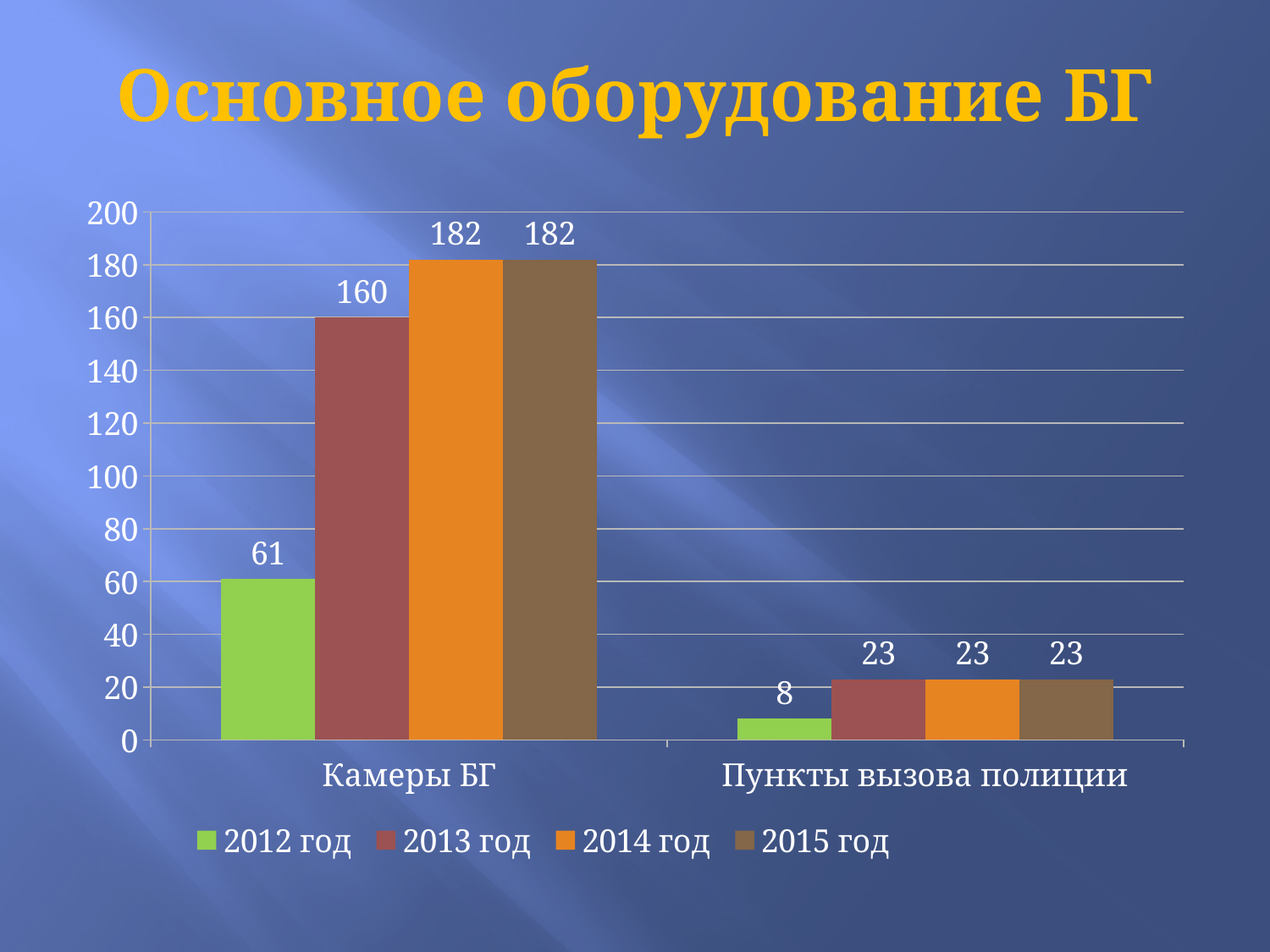
How many categories are shown on the x axis? 2 Which is larger: the 2013 год value for Камеры БГ or the 2014 год value for Камеры БГ? 2014 год What is the difference between the 2015 год and 2012 год values for Пункты вызова полиции? 15 How many series does the legend list? 4 What is the value for Пункты вызова полиции in 2012 год? 8 What is the title of the slide? Основное оборудование БГ What is the value for Камеры БГ in 2014 год? 182 What kind of chart is shown on the slide? Bar chart What is the value for Пункты вызова полиции in 2013 год? 23 What is the difference between the 2013 год and 2012 год values for Камеры БГ? 99 What is the value for Камеры БГ in 2012 год? 61 Which year has the lowest value for Камеры БГ? 2012 год